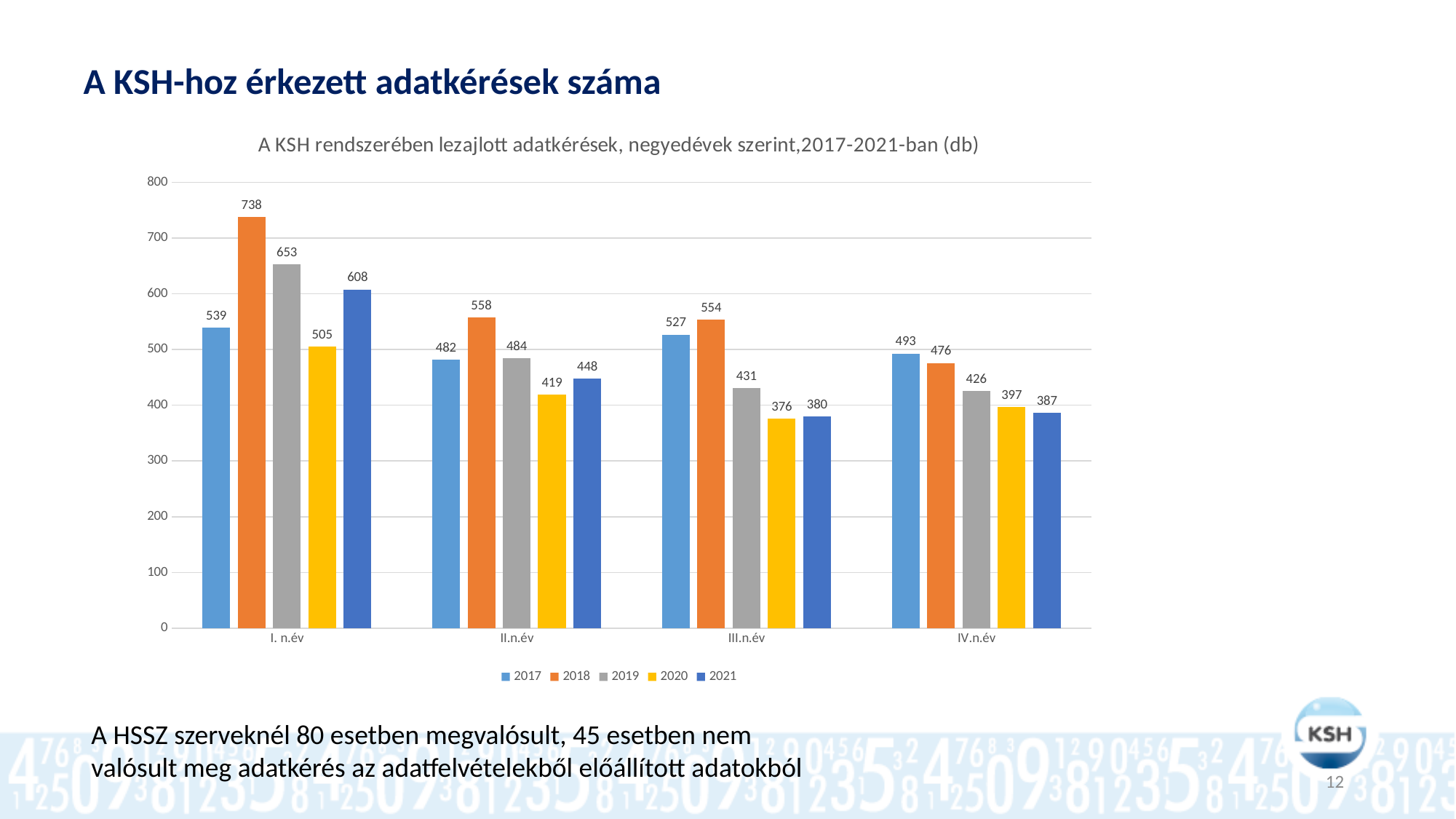
Which year has the lowest value in II.n.év? 2020 Is the value for 2019 in I. n.év greater or less than 600? greater What is the difference between the 2018 and 2017 values in I. n.év? 199 Do the values for 2020 rise or fall from I. n.év to III.n.év? fall How many series does the legend list? 5 What kind of chart is shown on the slide? bar chart What is the value for 2020 in III.n.év? 376 Which year has the highest value in I. n.év? 2018 What is the value for 2021 in IV.n.év? 387 What is the value for 2018 in I. n.év? 738 Which is larger in IV.n.év, the value for 2017 or the value for 2018? 2017 How many quarter categories are shown on the x axis? 4